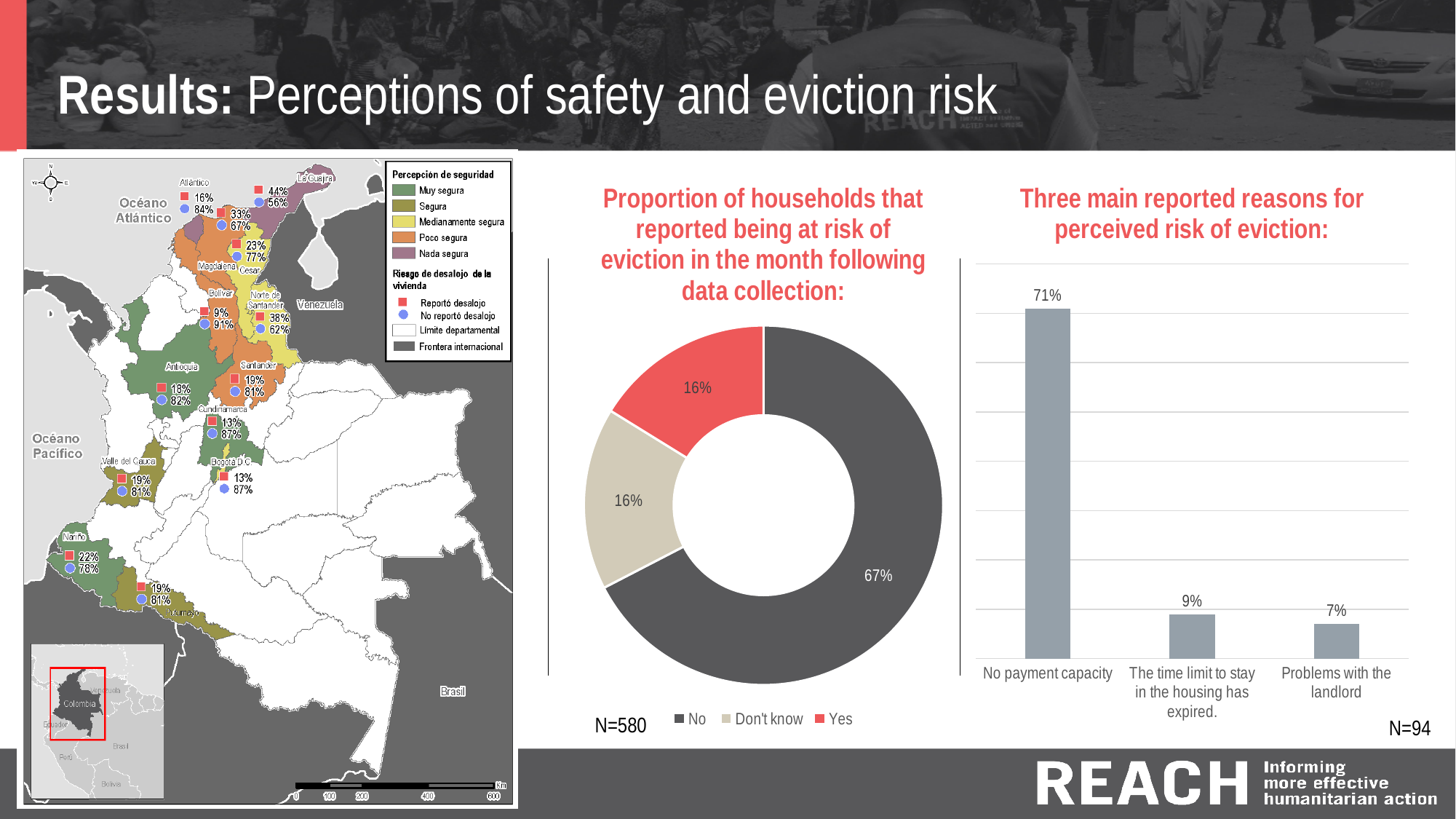
In the bar chart of the three main reported reasons for perceived risk of eviction, which reason has the lowest value? Problems with the landlord In the donut chart on the proportion of households at risk of eviction, which response has the largest share? No In the bar chart of the three main reported reasons for perceived risk of eviction, what is the value for "No payment capacity"? 71% In the donut chart on the proportion of households at risk of eviction, what is the sample size shown below the chart? N=580 In the donut chart on the proportion of households at risk of eviction, what share of households answered "Yes"? 16% In the bar chart of the three main reported reasons for perceived risk of eviction, how many categories are shown? 3 In the donut chart on the proportion of households at risk of eviction, how many entries does the legend list? 3 What kind of chart is used to show the three main reported reasons for perceived risk of eviction? Bar chart In the bar chart of the three main reported reasons for perceived risk of eviction, what is the difference between "No payment capacity" and "The time limit to stay in the housing has expired"? 62% In the bar chart of the three main reported reasons for perceived risk of eviction, what is the value for "Problems with the landlord"? 7% In the donut chart on the proportion of households at risk of eviction, what share of households answered "No"? 67% In the donut chart on the proportion of households at risk of eviction, what is the difference between the "No" share and the "Yes" share? 51%